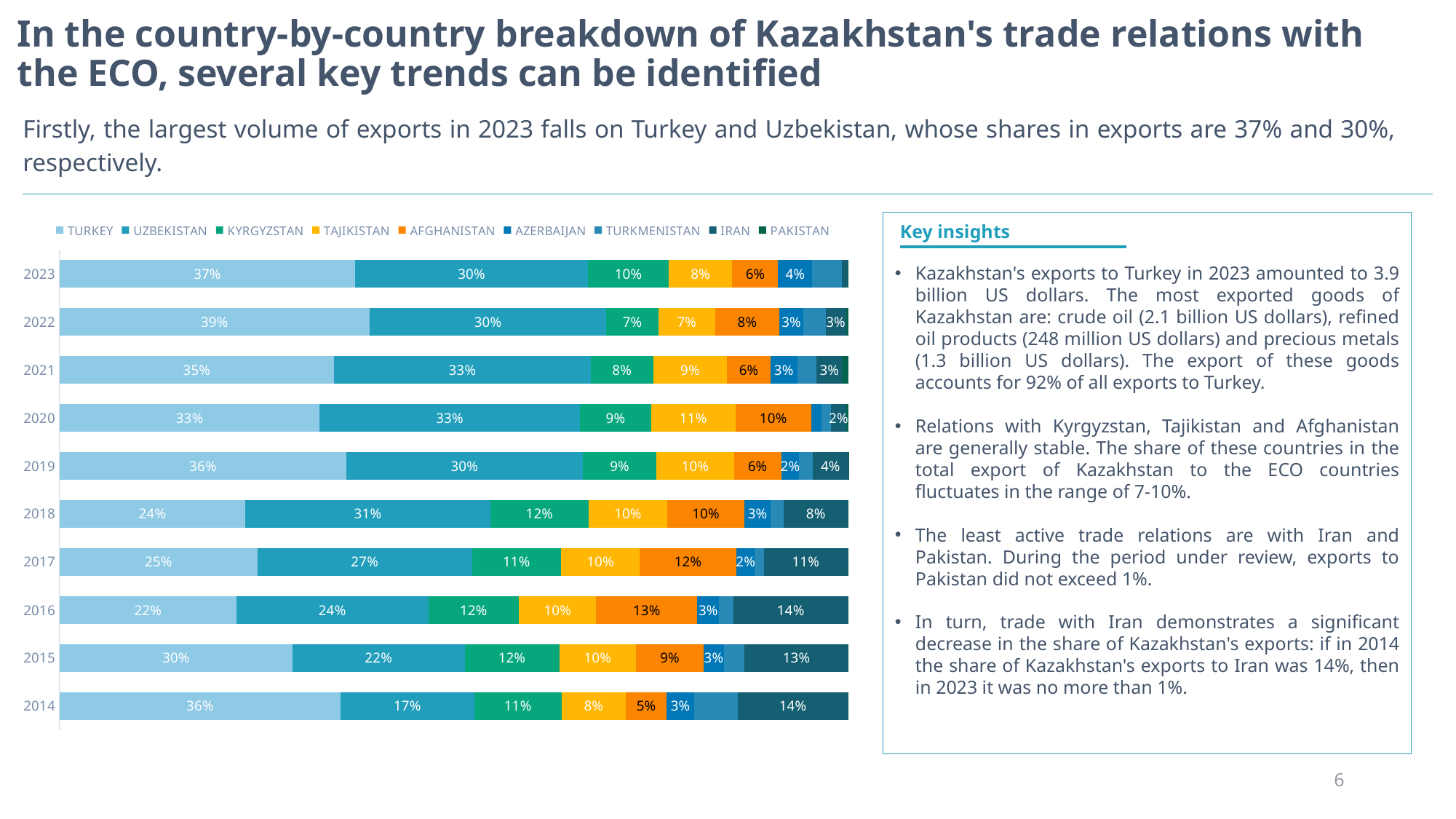
What is the share of Afghanistan in 2016? 13% In which year is Turkey's share the highest? 2022 What is the share of Uzbekistan in 2014? 17% What is the share of Turkey in 2023? 37% What is the difference between Turkey's share and Uzbekistan's share in 2023? 7% How many series does the legend list? 9 In which year is Turkey's share the lowest? 2016 Which country is listed first in the chart legend? Turkey What kind of chart is shown on the slide? Stacked bar chart How many years are shown on the chart? 10 Which is larger: Uzbekistan's share in 2021 or Uzbekistan's share in 2014? Uzbekistan's share in 2021 What is the share of Kyrgyzstan in 2018? 12%